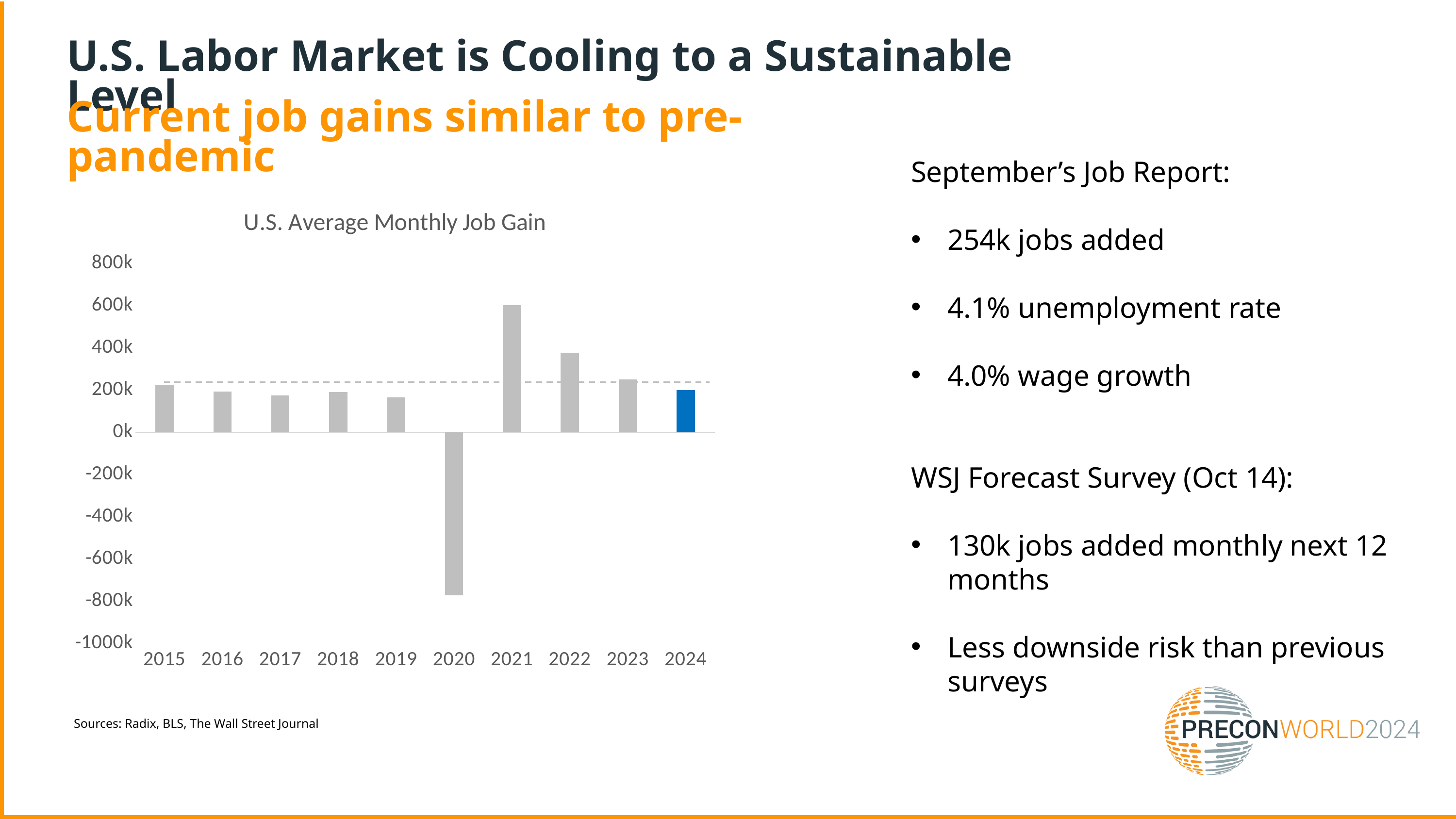
What is the title of the chart? U.S. Average Monthly Job Gain Which year has the larger average monthly job gain, 2022 or 2023? 2022 Which year has the lowest average monthly job gain in the chart? 2020 Is the value for 2015 greater or less than 400k? less Which year's bar is coloured blue rather than grey? 2024 What kind of chart is shown on the slide? Bar chart Is the value for 2020 greater or less than -600k? less Do the values rise or fall from 2021 to 2023? fall How many years are shown on the x axis of the chart? 10 Which year has the highest average monthly job gain in the chart? 2021 Is the value for 2022 greater or less than 200k? greater